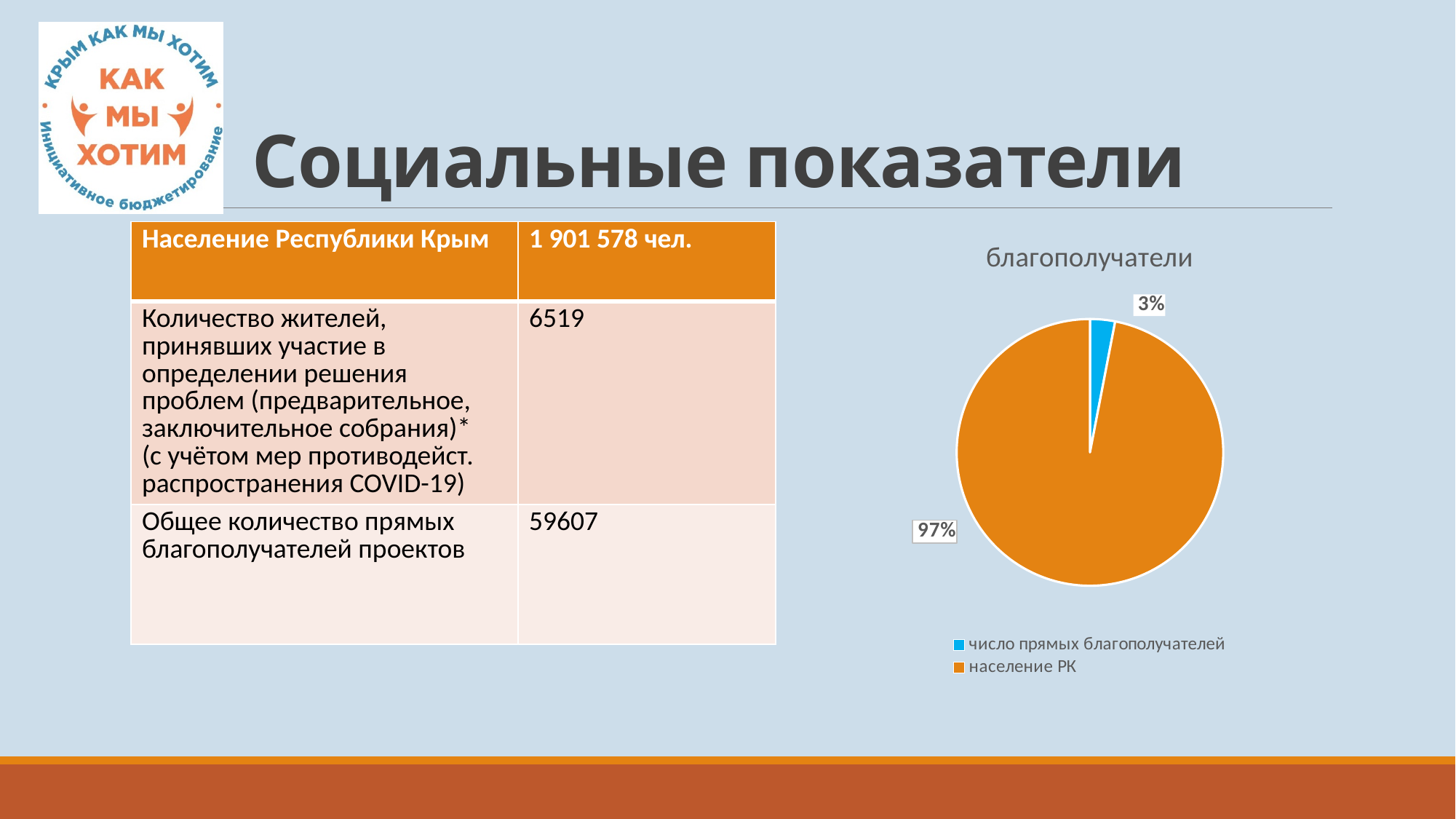
What is the title of the chart? благополучатели What colour is the "число прямых благополучателей" slice? blue Which is larger: the share for "население РК" or the share for "число прямых благополучателей"? население РК What share of the pie does "число прямых благополучателей" take? 3% How many entries does the chart legend list? 2 What kind of chart is shown on the slide? pie chart What is the difference in percentage points between the "население РК" slice and the "число прямых благополучателей" slice? 94% Which slice of the pie chart is the smallest? число прямых благополучателей What share of the pie does "население РК" take? 97% Which slice of the pie chart is the largest? население РК How many slices does the pie chart have? 2